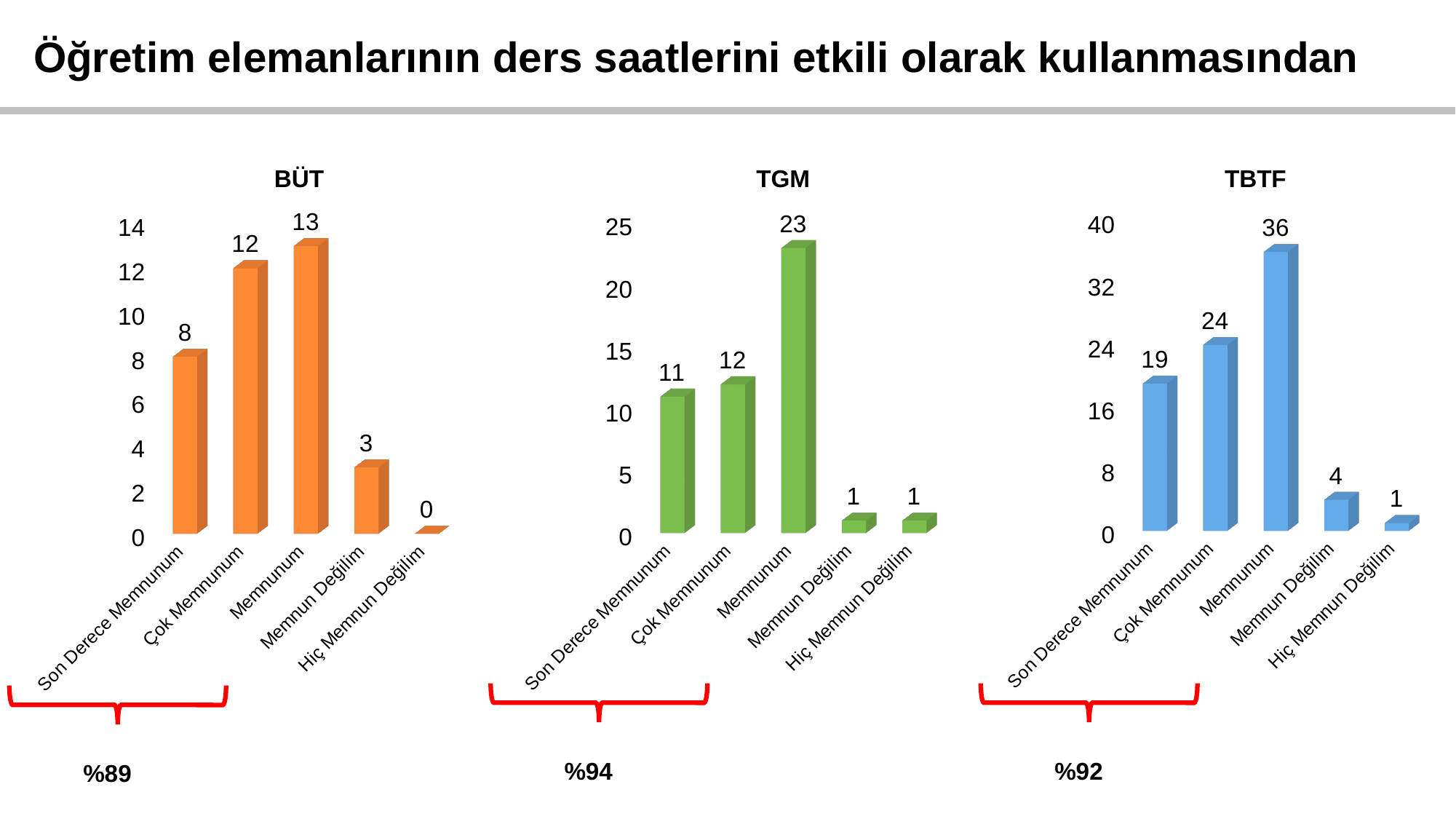
In the TBTF chart, which category has the highest value? Memnunum In the BÜT chart, what is the value for Memnunum? 13 What kind of chart is the TGM chart? bar chart In the TBTF chart, what is the difference between the values for Çok Memnunum and Son Derece Memnunum? 5 In the BÜT chart, which is larger, the value for Çok Memnunum or the value for Son Derece Memnunum? Çok Memnunum In the TBTF chart, what is the value for Memnun Değilim? 4 In the TGM chart, what is the value for Son Derece Memnunum? 11 In the TGM chart, is the value for Memnunum greater or less than 20? greater What colour are the bars in the TBTF chart? blue In the TGM chart, what is the difference between the values for Memnunum and Çok Memnunum? 11 In the BÜT chart, which category has the lowest value? Hiç Memnun Değilim How many categories does the TBTF chart show? 5